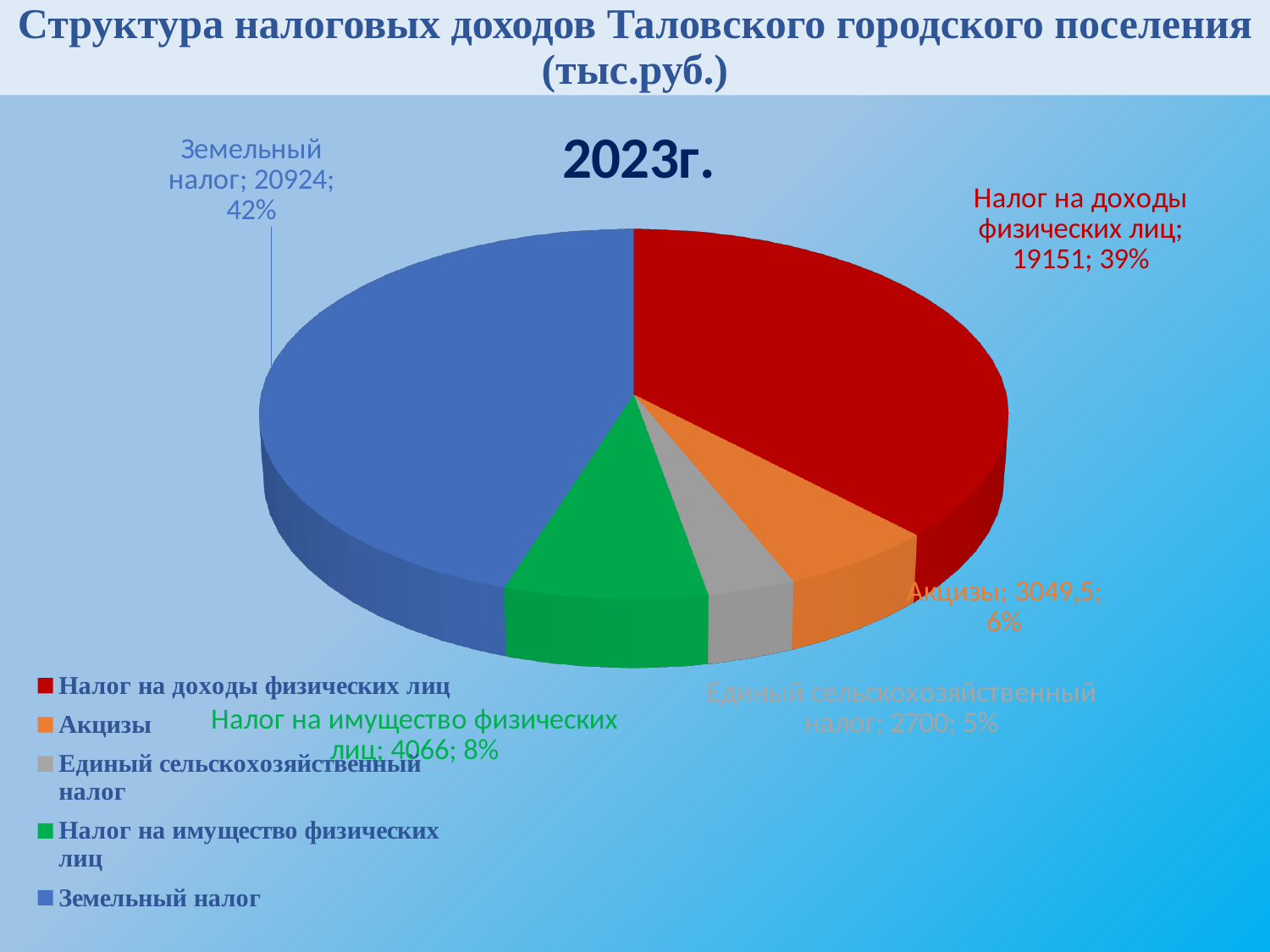
What value is shown for Налог на доходы физических лиц? 19151 What type of chart is shown on the slide? Pie chart What value is shown for Акцизы? 3049,5 What value is shown for Налог на имущество физических лиц? 4066 What share of the pie does Земельный налог represent? 42% Which is larger, the value for Акцизы or the value for Налог на имущество физических лиц? Налог на имущество физических лиц Which category has the smallest slice of the pie? Единый сельскохозяйственный налог Which category has the largest slice of the pie? Земельный налог What is the difference between the values for Земельный налог and Налог на доходы физических лиц? 1773 What value is shown for Земельный налог in the pie chart? 20924 What share of the pie does Единый сельскохозяйственный налог represent? 5% How many categories are shown in the pie chart? 5